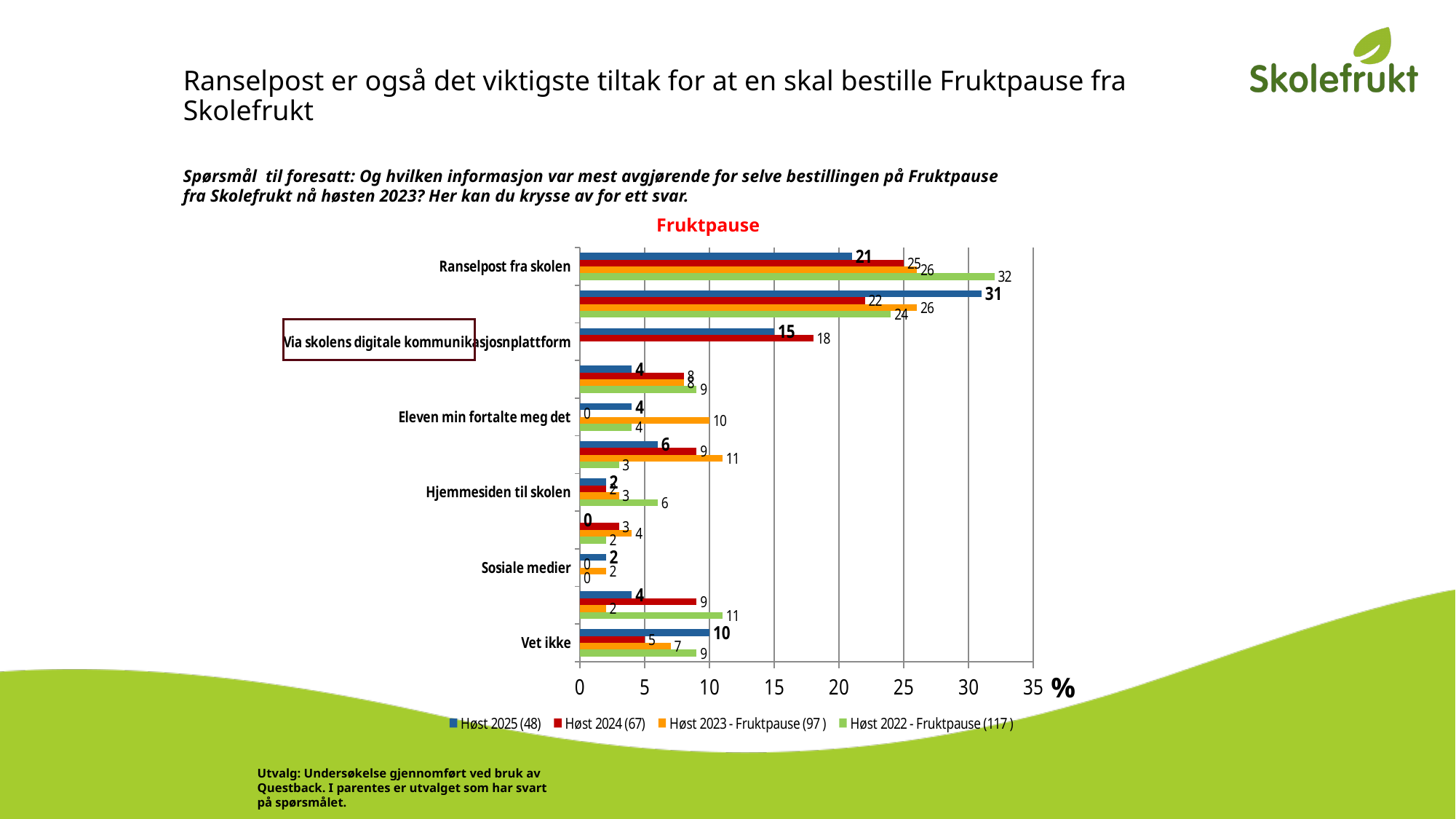
What is the value for Via skolens digitale kommunikasjosnplattform in the Høst 2024 (67) series? 18 Which series has the highest value for Ranselpost fra skolen? Høst 2022 - Fruktpause (117) What is the value for Hjemmesiden til skolen in the Høst 2022 - Fruktpause (117) series? 6 What is the title of the chart? Fruktpause How many series does the legend list? 4 What is the value for Ranselpost fra skolen in the Høst 2022 - Fruktpause (117) series? 32 What kind of chart is shown on the slide? bar chart What is the value for Eleven min fortalte meg det in the Høst 2023 - Fruktpause (97) series? 10 What is the difference between the Høst 2022 and Høst 2025 values for Ranselpost fra skolen? 11 What is the value for Ranselpost fra skolen in the Høst 2025 (48) series? 21 For Vet ikke, which is larger: the Høst 2025 (48) value or the Høst 2024 (67) value? Høst 2025 (48) What is the value for Vet ikke in the Høst 2025 (48) series? 10